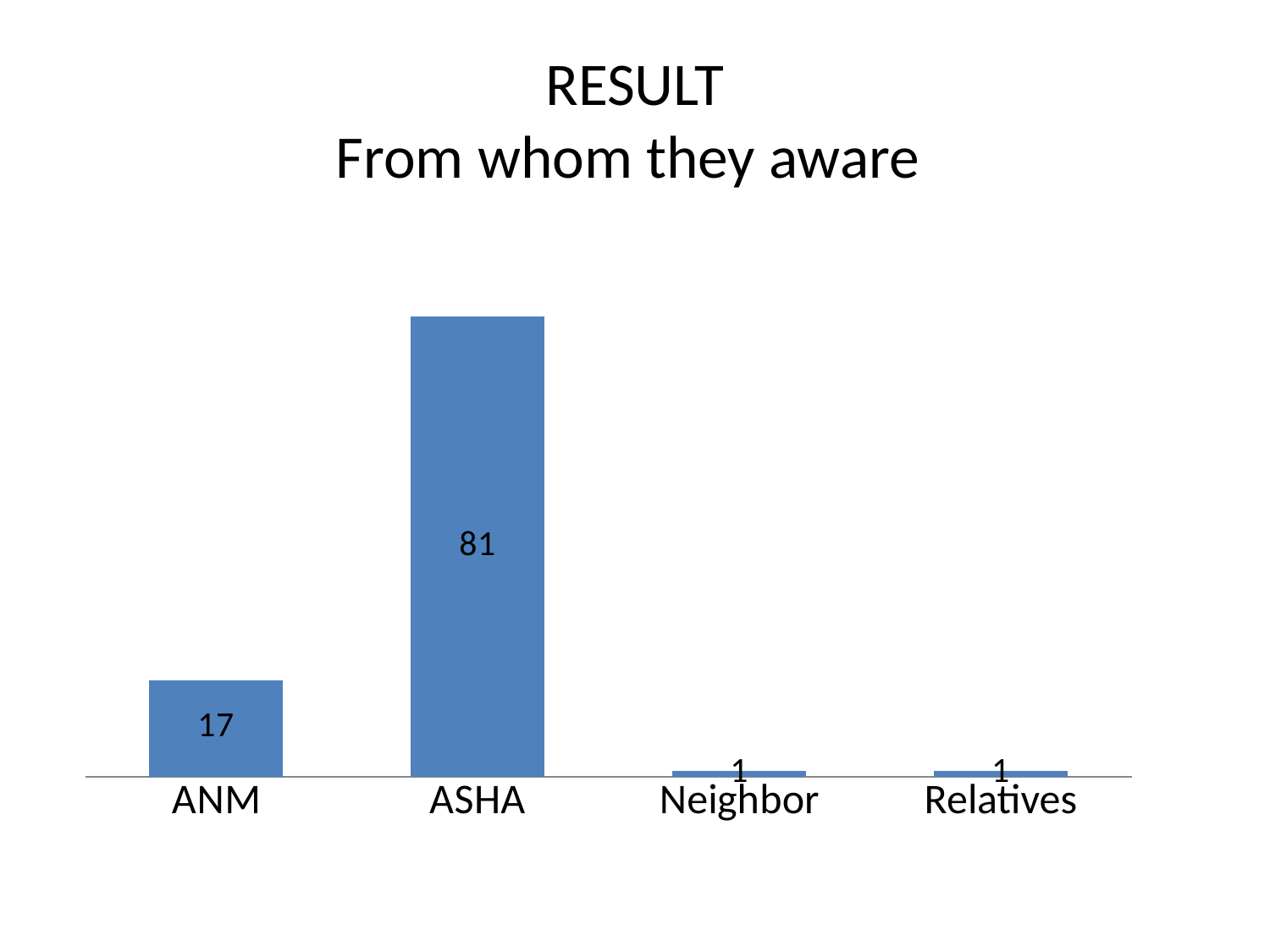
Which is larger, the value for ANM or the value for Neighbor? ANM What is the title of the slide? RESULT From whom they aware What is the difference between the values for ASHA and ANM? 64 How many categories are shown on the x axis? 4 What kind of chart is shown on the slide? Bar chart Which category has the highest value? ASHA What colour are the bars in the chart? Blue What is the value for ASHA? 81 What is the value for Relatives? 1 What is the value for Neighbor? 1 What is the value for ANM? 17 What is the total of the values for Neighbor and Relatives? 2